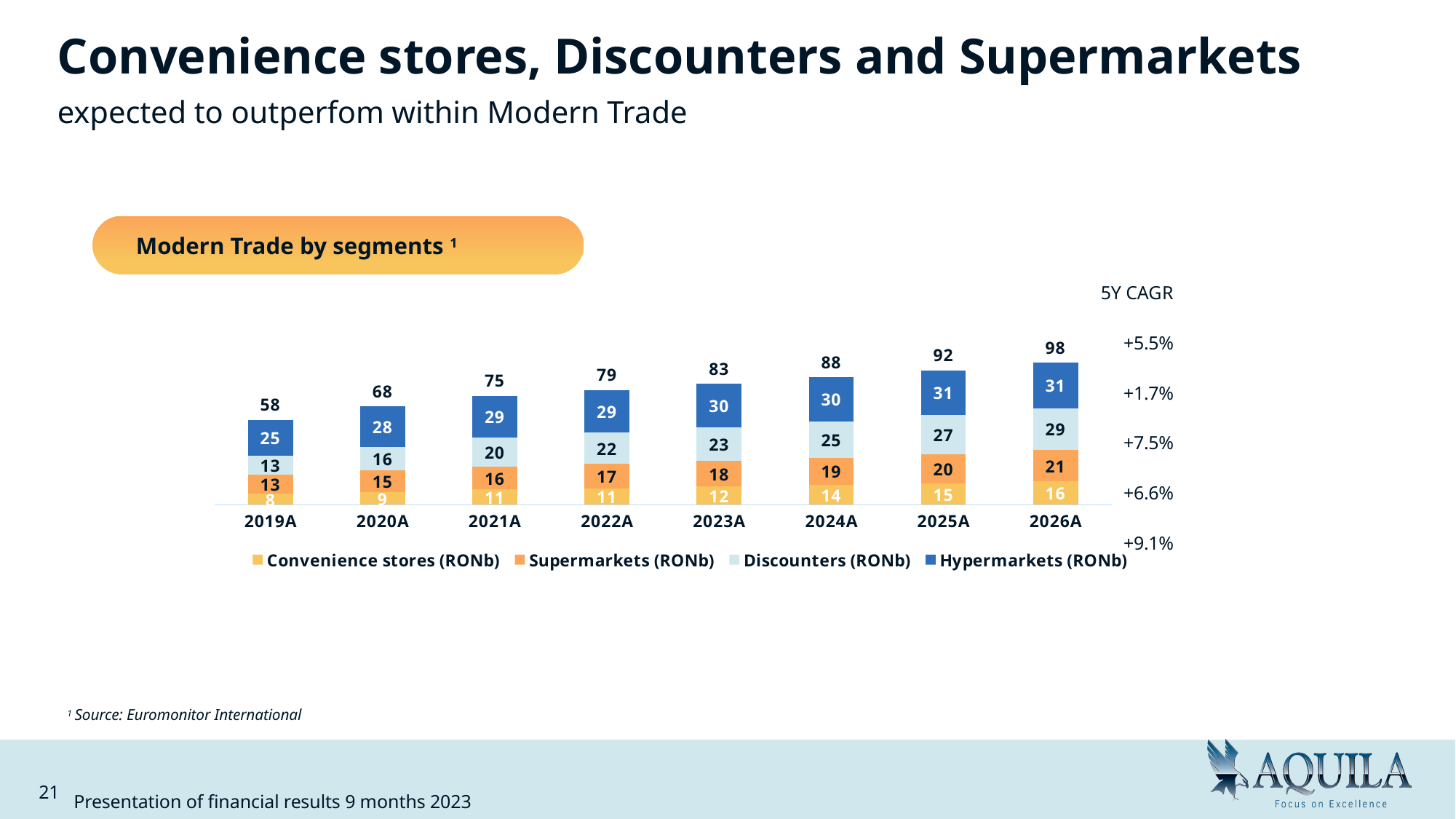
What is the total of the stacked bar for 2022A? 79 What is the value for Hypermarkets (RONb) in 2023A? 30 What is the value for Convenience stores (RONb) in 2026A? 16 Which is larger in 2020A: Discounters (RONb) or Supermarkets (RONb)? Discounters (RONb) How many years are shown on the x axis? 8 What is the value for Supermarkets (RONb) in 2021A? 16 Which year has the lowest total Modern Trade value? 2019A What is the value for Discounters (RONb) in 2025A? 27 How many series does the legend list? 4 What is the difference between the total for 2026A and the total for 2019A? 40 What kind of chart is shown on the slide? Stacked bar chart Which year has the highest total Modern Trade value? 2026A